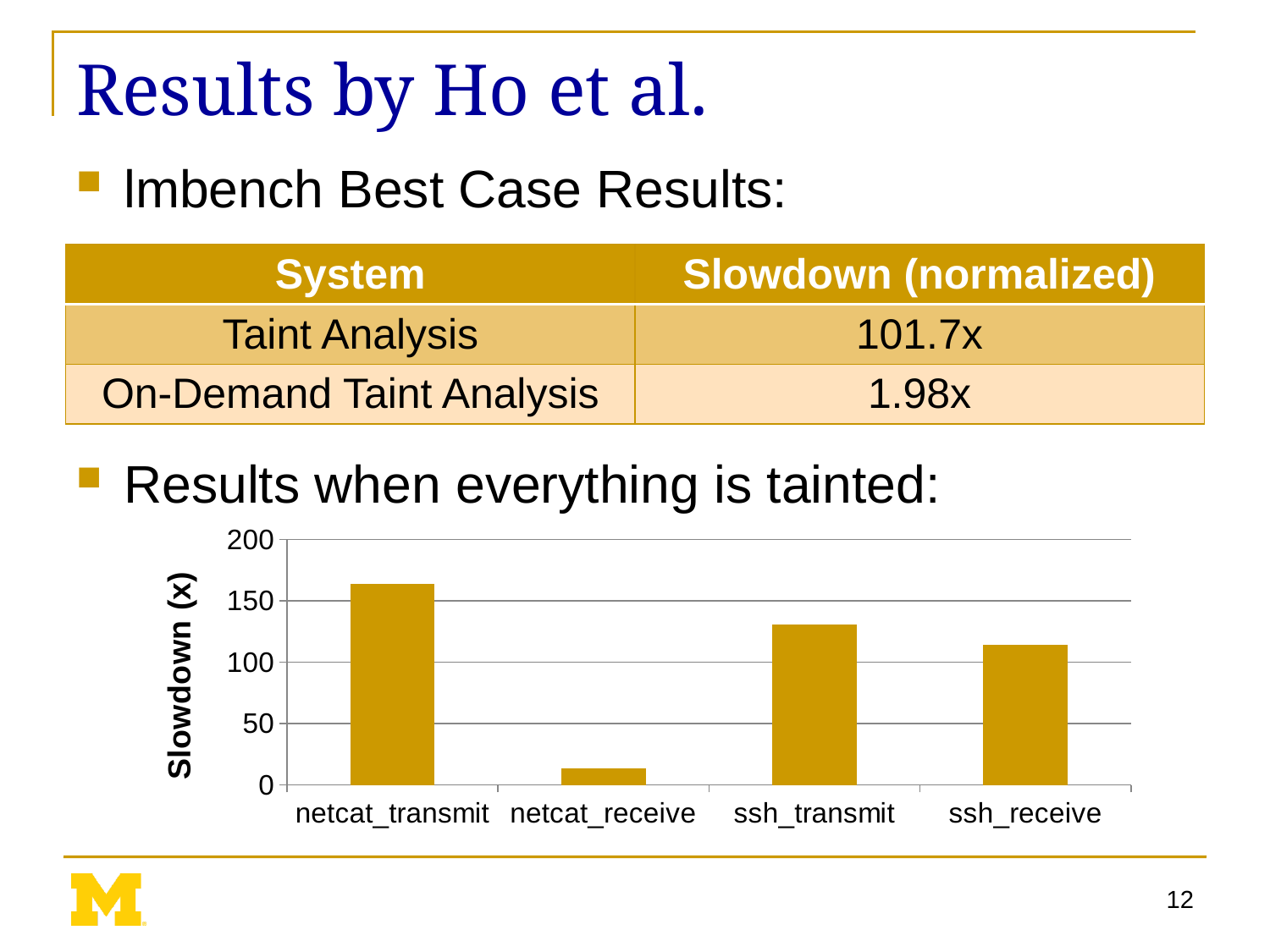
Is the value for ssh_receive greater or less than 150? less How many categories are shown on the x axis of the chart? 4 What is the label of the vertical axis of the chart? Slowdown (x) Which has a larger slowdown, ssh_transmit or ssh_receive? ssh_transmit Is the value for netcat_receive greater or less than 50? less Is the value for netcat_transmit greater or less than 150? greater Which has a larger slowdown, netcat_receive or ssh_receive? ssh_receive What is the maximum value shown on the vertical axis of the chart? 200 Which category has the lowest slowdown in the bar chart? netcat_receive What kind of chart is shown on the slide? bar chart Which category has the highest slowdown in the bar chart? netcat_transmit